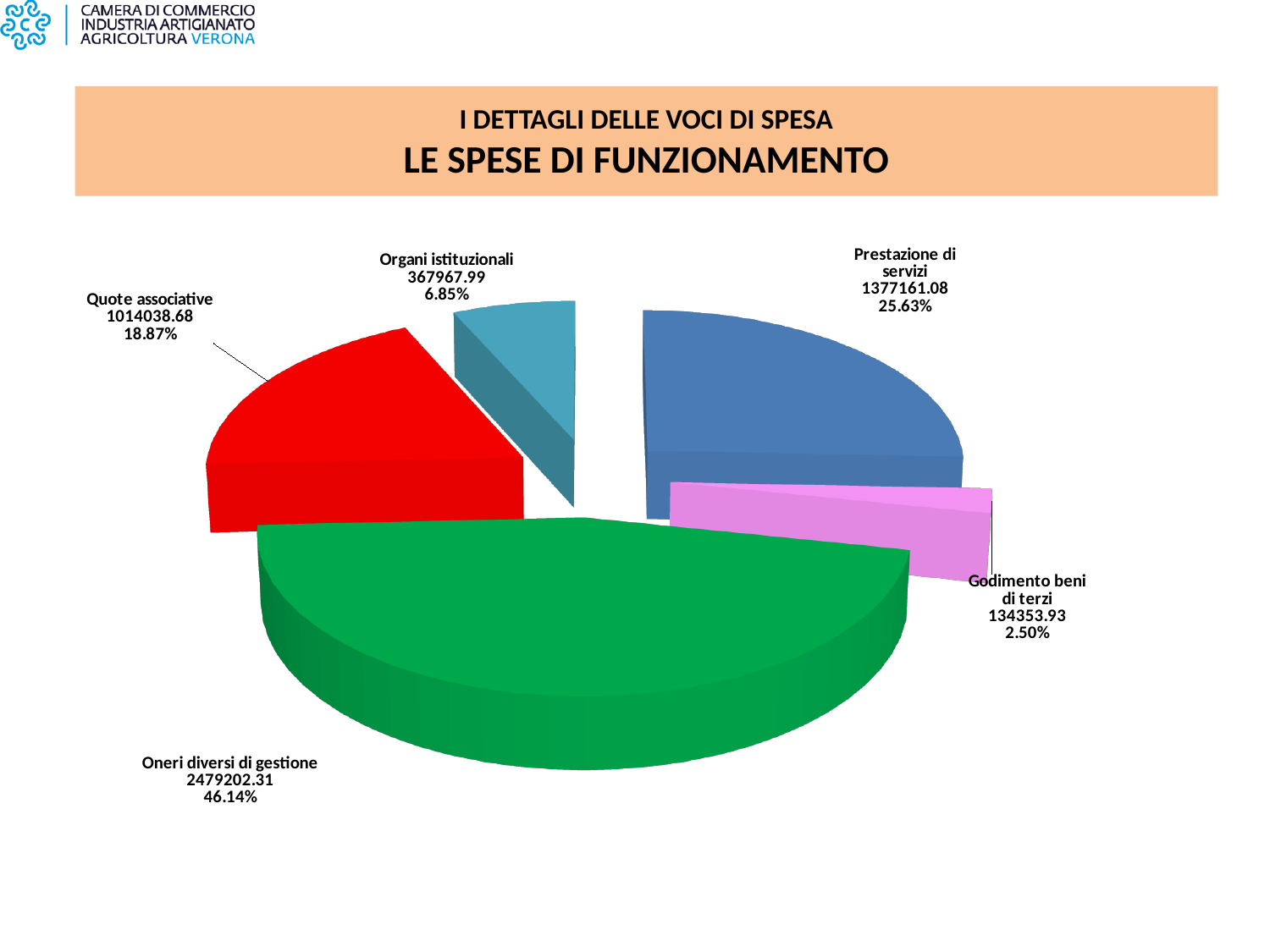
What kind of chart is shown on the slide? Pie chart What percentage share does Quote associative have? 18.87% What percentage share does Organi istituzionali have? 6.85% What is the value for Godimento beni di terzi? 134353.93 Which category has the smallest value? Godimento beni di terzi Which is larger, Quote associative or Organi istituzionali? Quote associative Which category has the largest value? Oneri diversi di gestione How many slices does the pie chart have? 5 What is the value for Prestazione di servizi? 1377161.08 What is the difference between the values for Prestazione di servizi and Quote associative? 363122.40 What colour is the slice for Oneri diversi di gestione? Green What is the value for Oneri diversi di gestione? 2479202.31